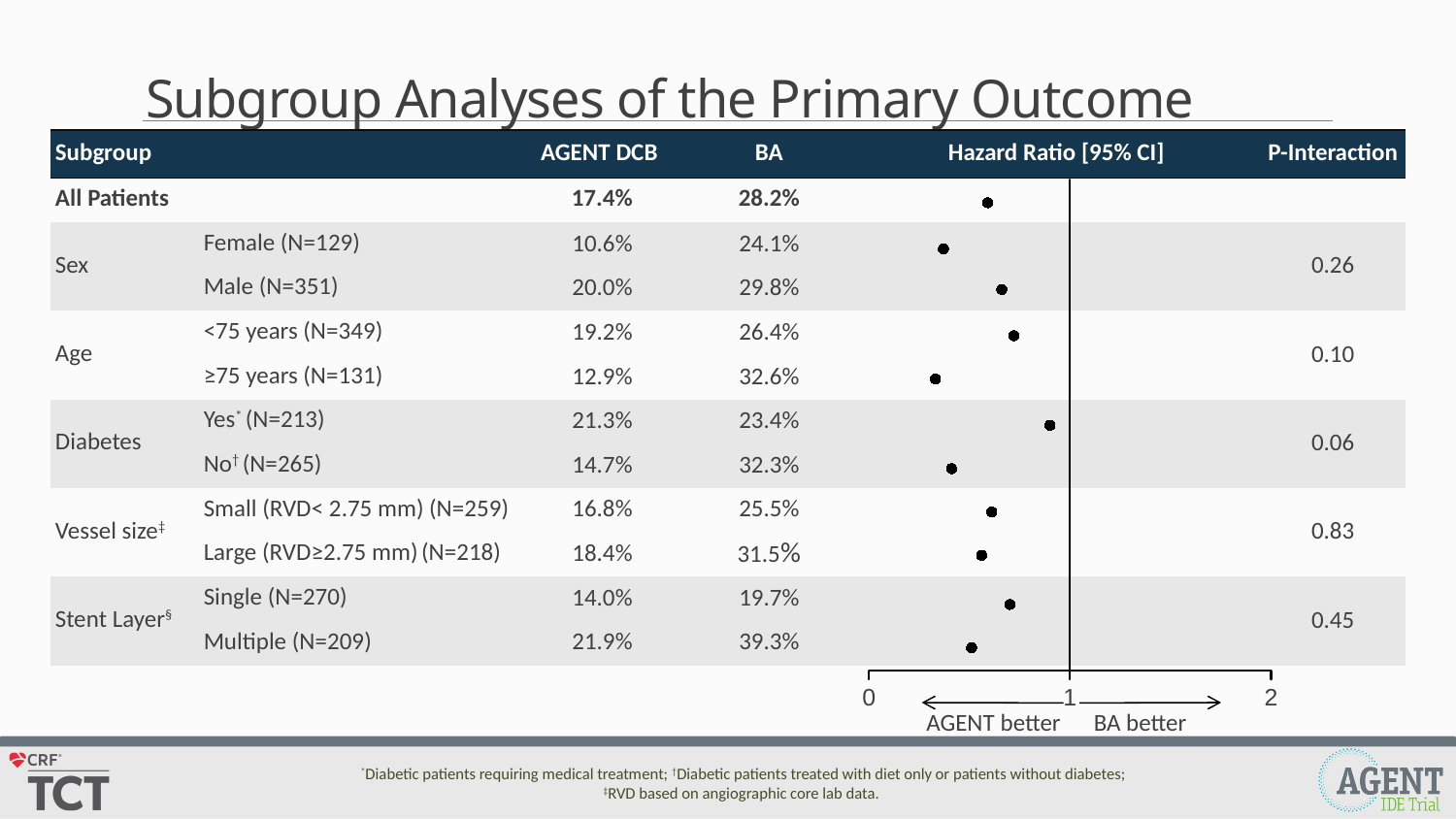
Is the hazard ratio point for the Female (N=129) subgroup greater or less than 1? less Which has the higher BA value: Single (N=270) or Multiple (N=209) stent layer? Multiple (N=209) What is the AGENT DCB value for the ≥75 years (N=131) subgroup? 12.9% What is the AGENT DCB value for All Patients? 17.4% Which subgroup category has the highest P-Interaction value? Vessel size What kind of chart is used to display the hazard ratios? Forest plot What is the difference between the BA and AGENT DCB values for All Patients? 10.8 percentage points Which subgroup has the lowest AGENT DCB value? Female (N=129) What is the BA value for the Multiple (N=209) stent layer subgroup? 39.3% What is the P-Interaction value for the Diabetes subgroup? 0.06 Which subgroup has the highest BA value? Multiple (N=209) Is the hazard ratio point for the Multiple (N=209) stent layer subgroup greater or less than 1? less